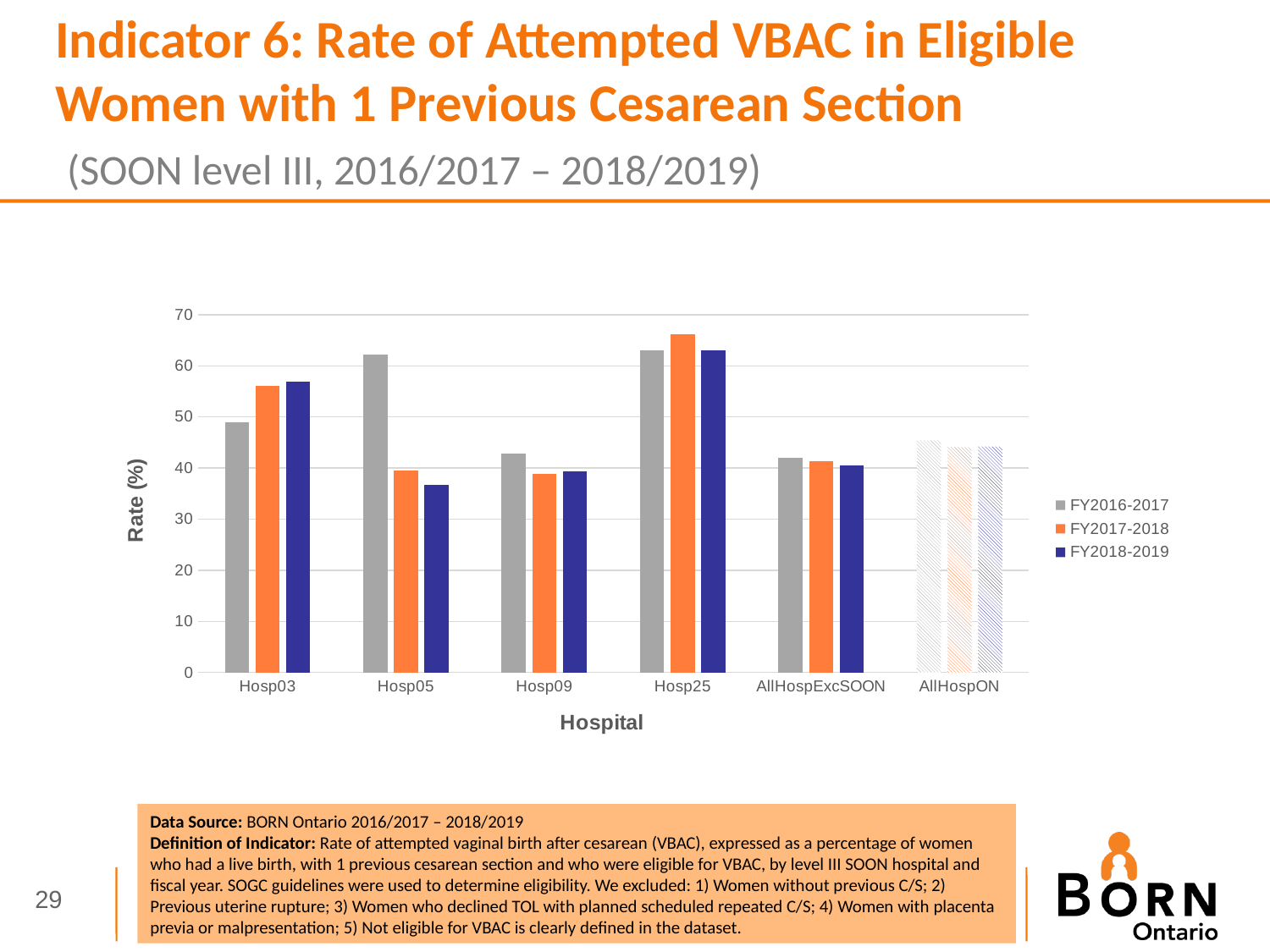
Which hospital has the lowest FY2018-2019 value? Hosp05 Which hospital has the highest FY2017-2018 value? Hosp25 What is the title of the y axis? Rate (%) Is the FY2016-2017 value for AllHospON greater or less than 50? less What kind of chart is shown on the slide? Bar chart How many series does the legend list? 3 How many hospital categories are shown on the x axis? 6 Do the values for Hosp03 rise or fall from FY2016-2017 to FY2018-2019? rise Is the FY2016-2017 value for Hosp05 greater or less than 60? greater Do the values for Hosp05 rise or fall from FY2016-2017 to FY2018-2019? fall Is the FY2018-2019 value for Hosp05 greater or less than 40? less Which is larger for FY2016-2017: Hosp03 or Hosp05? Hosp05